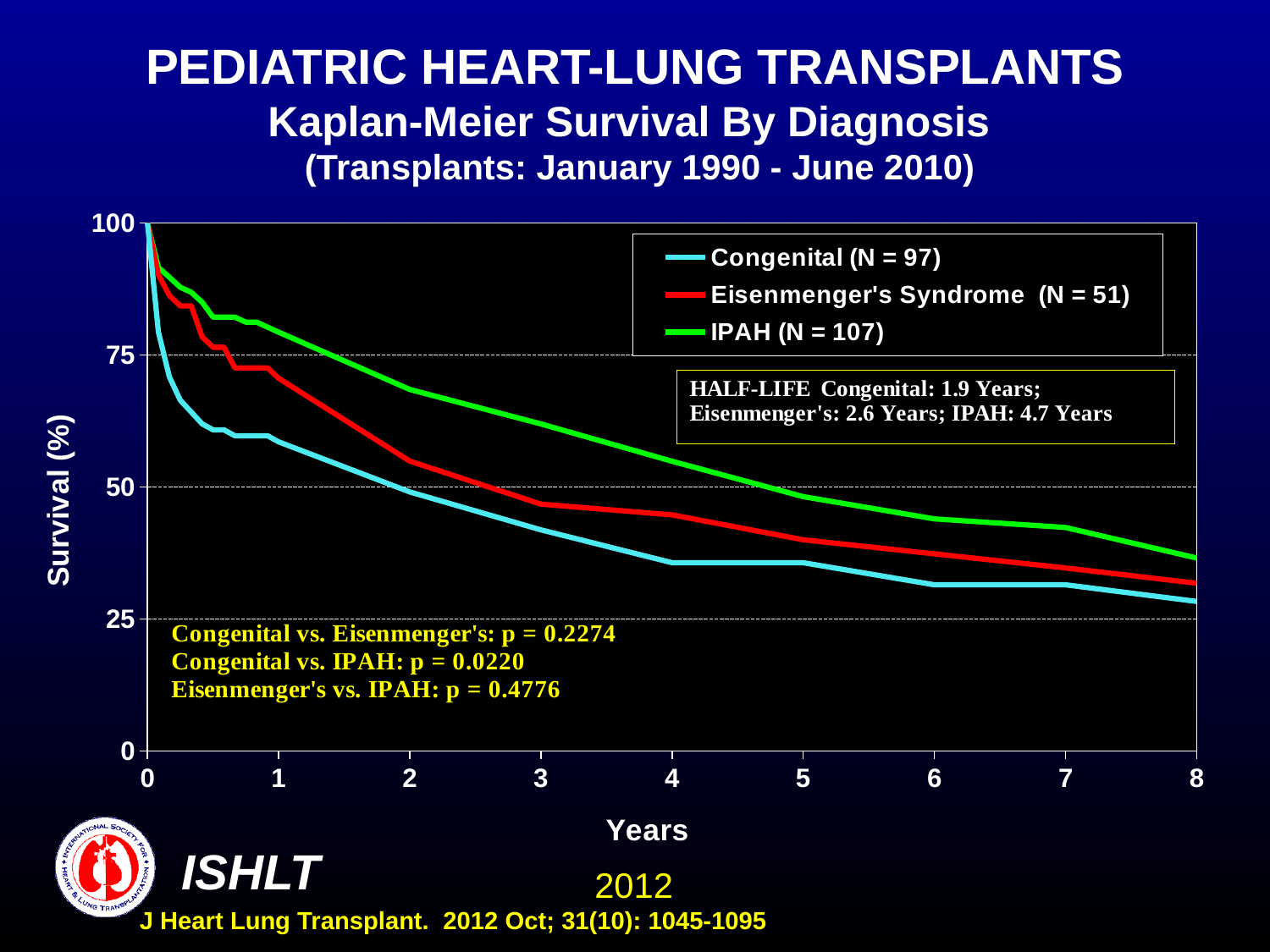
What is the N for the Congenital group shown in the legend? 97 How many series does the legend list? 3 Do the survival curves rise or fall as years since transplant increase? Fall What kind of chart is shown on the slide? Line chart What is the N for the IPAH group shown in the legend? 107 Which diagnosis group has the highest survival at 8 years? IPAH What is the p-value for Congenital vs. IPAH? 0.0220 What is the half-life for IPAH stated on the chart? 4.7 Years Is the survival for IPAH at 4 years greater or less than 50? greater Is the survival for Congenital at 6 years greater or less than 50? less What is the half-life for Eisenmenger's Syndrome stated on the chart? 2.6 Years Which diagnosis group has the lowest survival at 4 years? Congenital